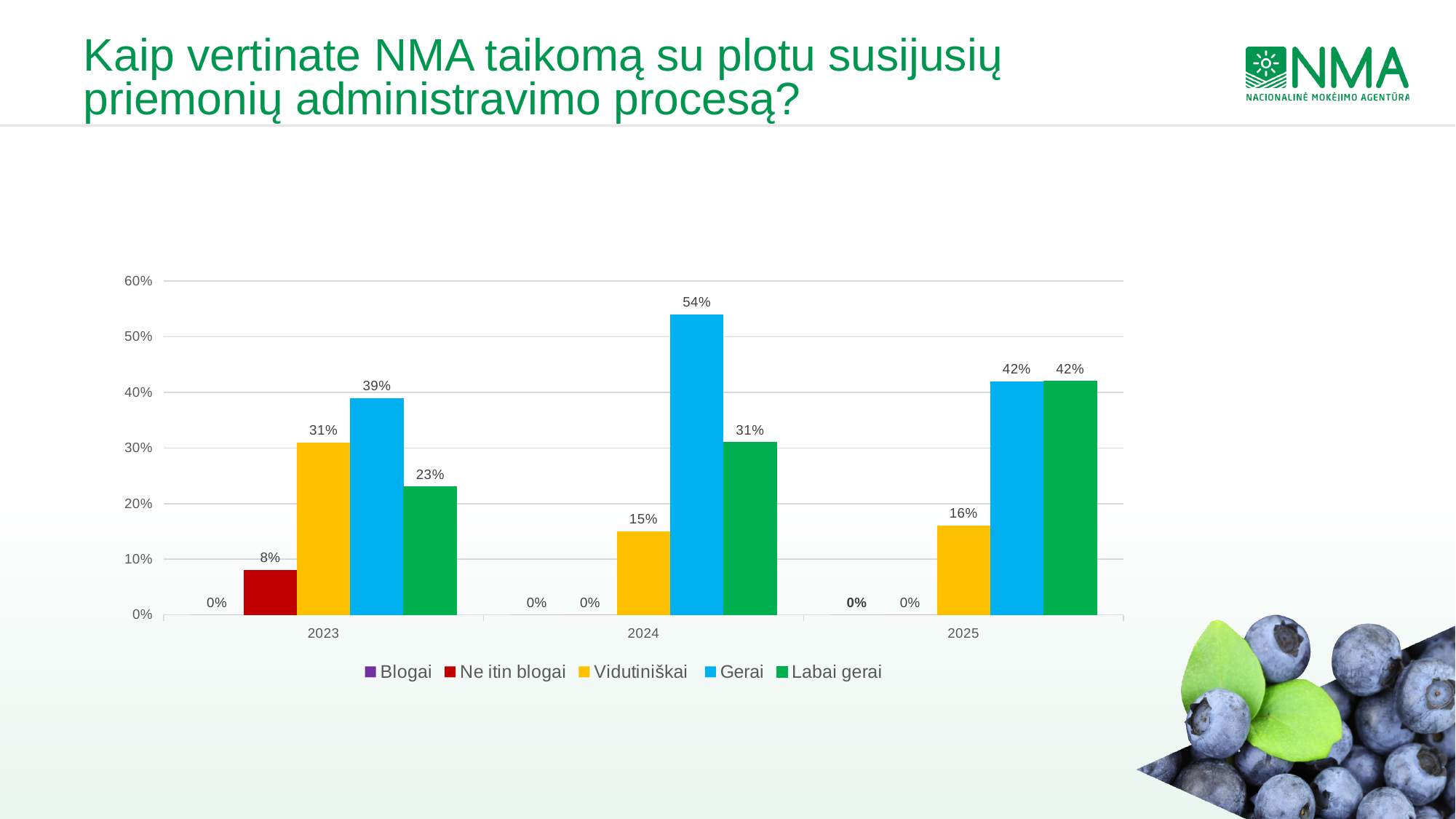
What kind of chart is shown on the slide? Bar chart What is the value for Vidutiniškai in 2024? 15% What is the difference between the Gerai and Labai gerai values in 2024? 23% What is the value for Ne itin blogai in 2023? 8% What is the value for Gerai in 2024? 54% Does the Vidutiniškai value rise or fall from 2023 to 2024? Fall In which year is the Gerai value highest? 2024 Which series has the highest value in 2023? Gerai How many series does the legend list? 5 Which is larger in 2023: Vidutiniškai or Labai gerai? Vidutiniškai What is the value for Labai gerai in 2025? 42% How many year categories are shown on the x axis? 3